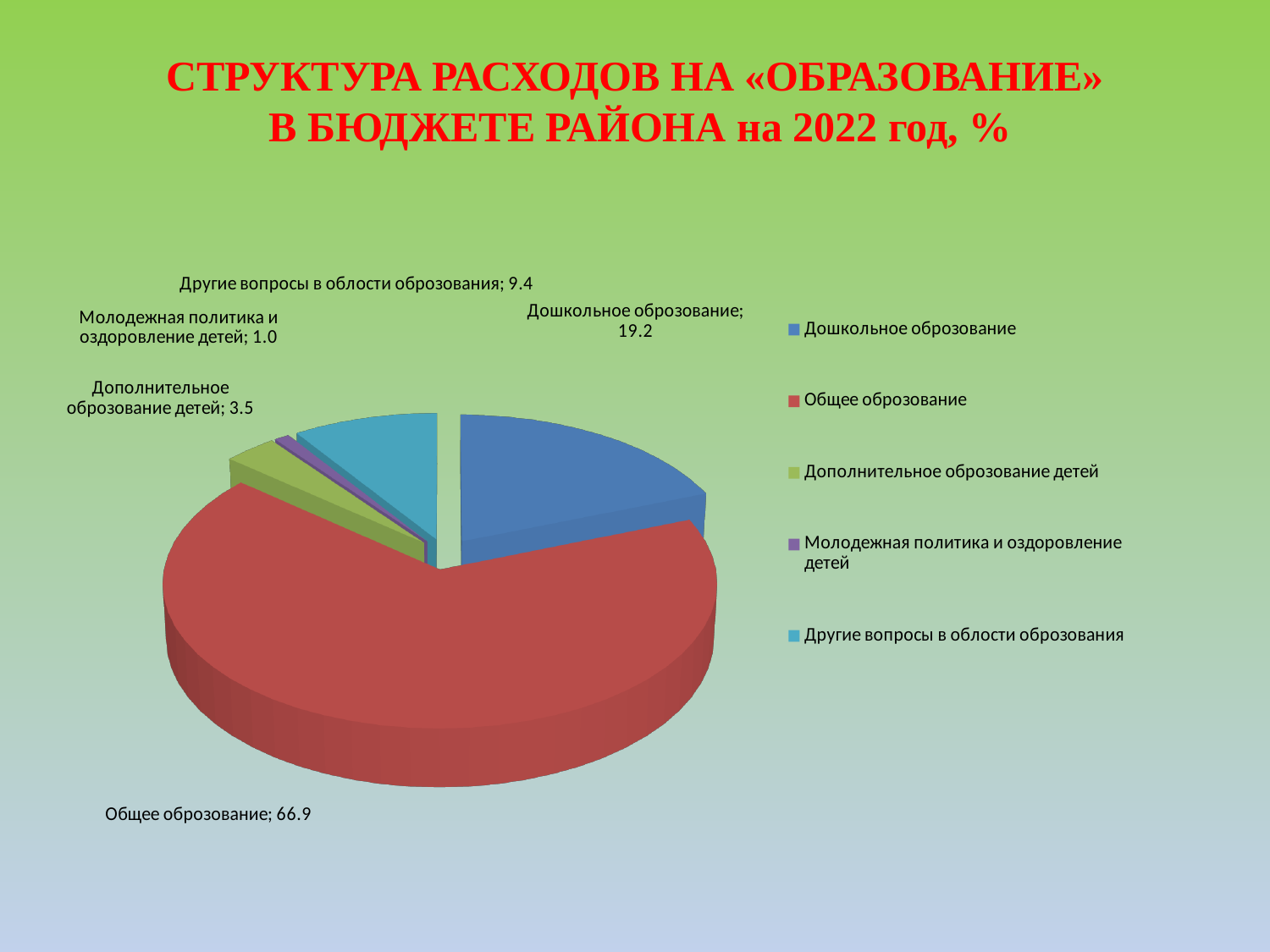
How many categories does the pie chart have? 5 Which is larger, the value for Другие вопросы в облости оброзования or the value for Дополнительное оброзование детей? Другие вопросы в облости оброзования What is the value for Общее оброзование? 66.9 What kind of chart is shown on the slide? Pie chart What is the value for Дошкольное оброзование? 19.2 Which category has the largest slice of the pie? Общее оброзование What is the value for Дополнительное оброзование детей? 3.5 What colour is the slice for Общее оброзование? Red What is the value for Другие вопросы в облости оброзования? 9.4 What is the difference between the values for Общее оброзование and Дошкольное оброзование? 47.7 What is the value for Молодежная политика и оздоровление детей? 1.0 Which category has the smallest slice of the pie? Молодежная политика и оздоровление детей